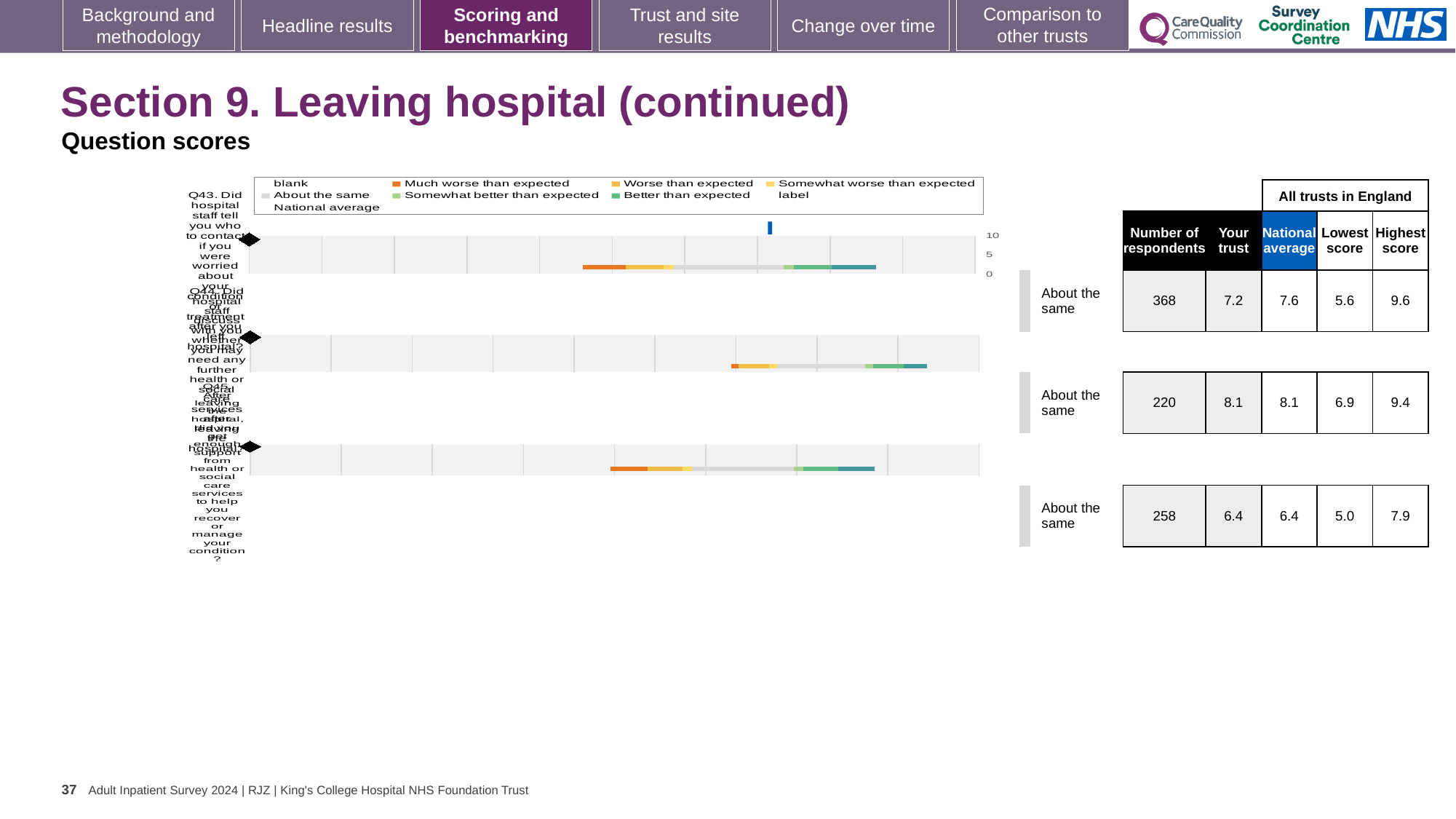
What kind of chart is used for the three question rows on the slide? bar chart Which of the three charts has the highest 'Your trust' score? The second chart from the top (8.1) For the first chart from the top (Q43), what is the number of respondents shown in the table? 368 What benchmark category label is shown next to each of the three charts? About the same For the second chart from the top, what is the lowest score among all trusts in England? 6.9 In the legend, what colour represents 'Much worse than expected'? Orange For the first chart from the top (Q43), which is larger: the 'Your trust' score or the national average? National average For the first chart from the top (Q43), what is the national average score? 7.6 For the third chart from the top, what is the highest score among all trusts in England? 7.9 For the first chart from the top (Q43), what is the 'Your trust' score? 7.2 How many question charts (rows of bars) are shown on the slide? 3 For the first chart from the top (Q43), what is the difference between the national average and the 'Your trust' score? 0.4